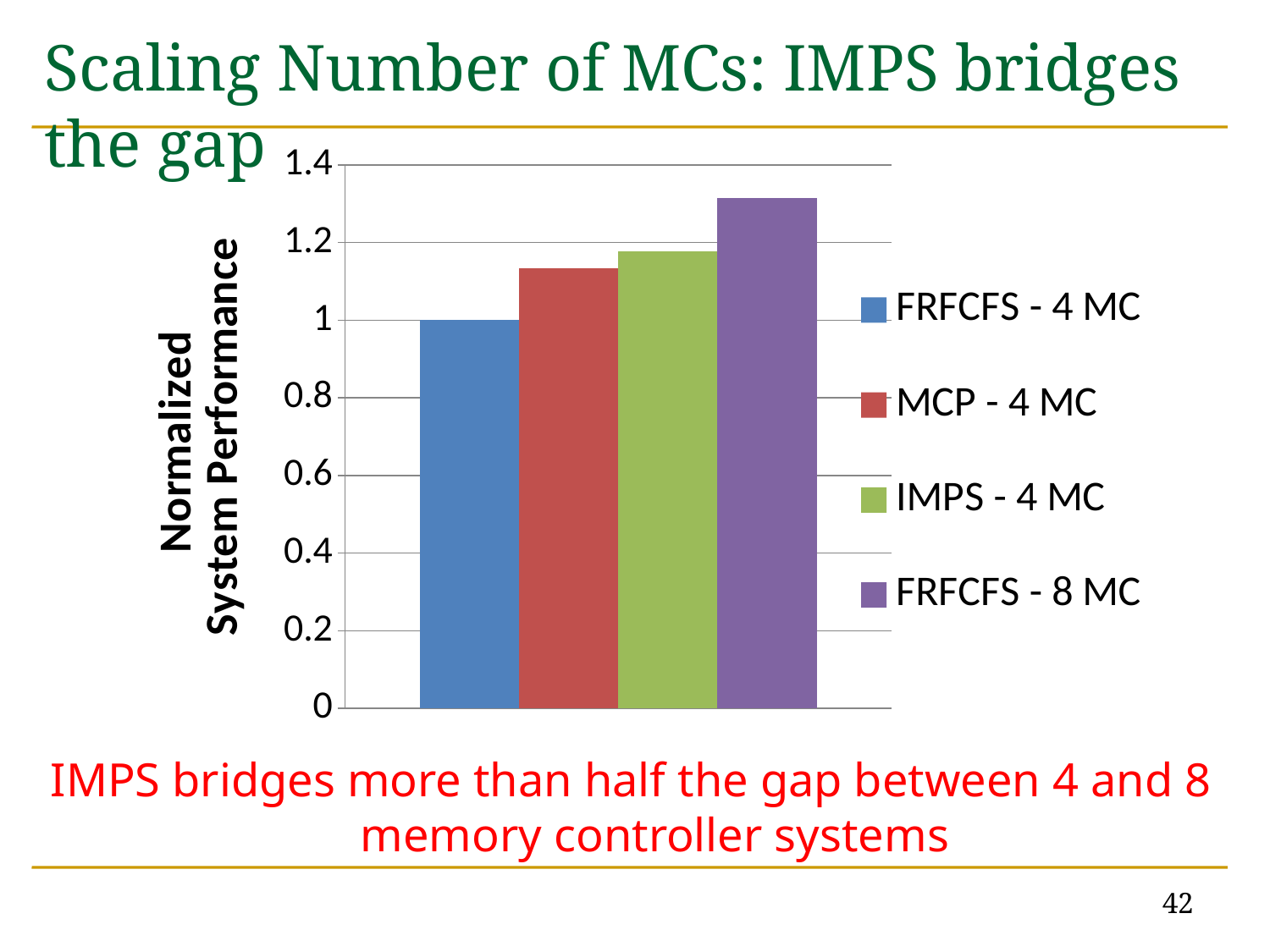
Which series has the highest normalized system performance? FRFCFS - 8 MC What is the label of the vertical axis? Normalized System Performance Is the value for FRFCFS - 8 MC greater or less than 1.2? greater What colour is the bar for IMPS - 4 MC? green What is the normalized system performance for FRFCFS - 4 MC? 1 What kind of chart is shown on the slide? bar chart Which is larger, the value for FRFCFS - 8 MC or the value for IMPS - 4 MC? FRFCFS - 8 MC How many bars are plotted in the chart? 4 Is the value for IMPS - 4 MC greater or less than 1.2? less How many series does the legend list? 4 Is the value for MCP - 4 MC greater or less than 1? greater Which series has the lowest normalized system performance? FRFCFS - 4 MC